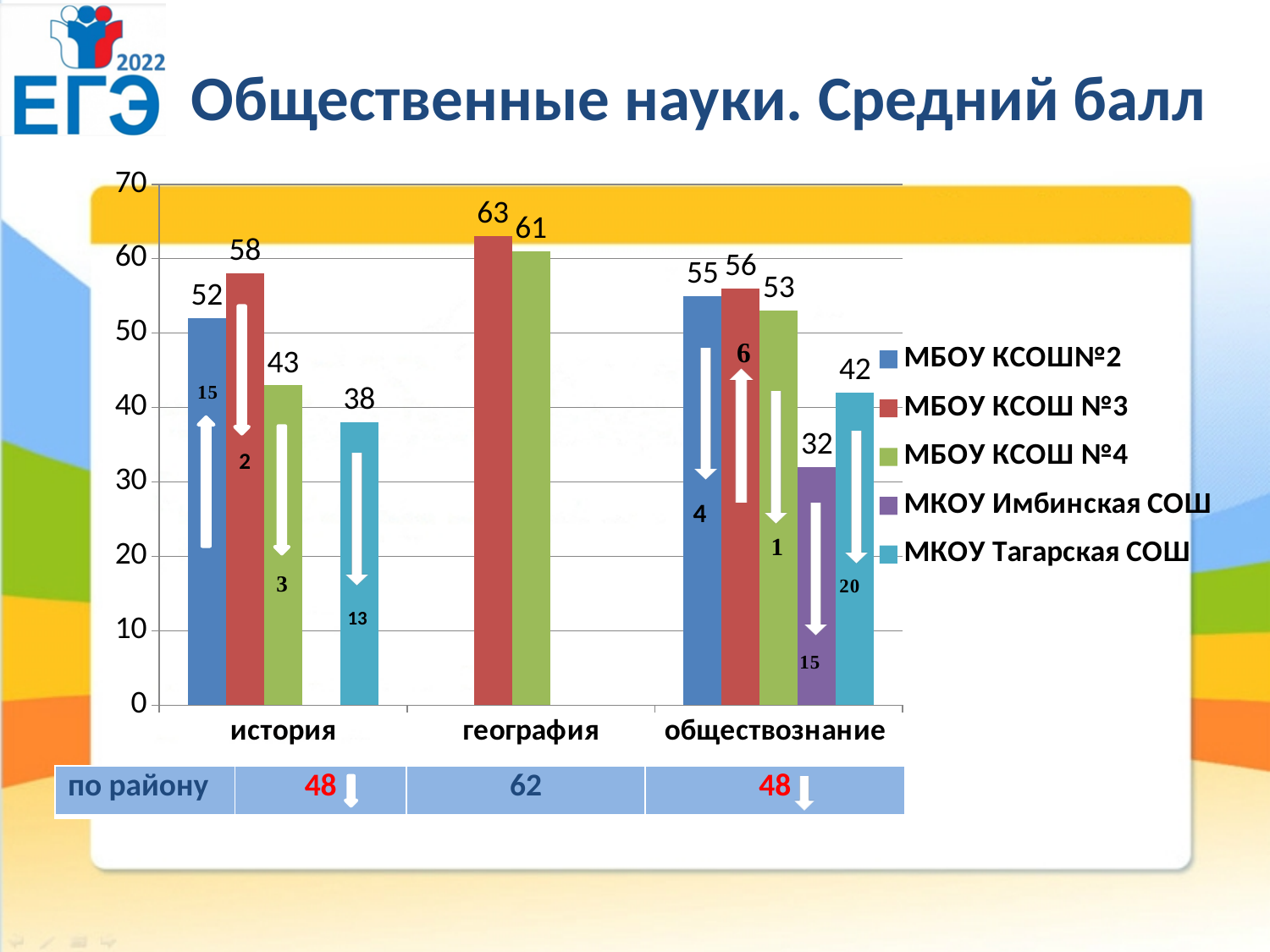
Which school has the lowest average score in обществознание? МКОУ Имбинская СОШ What is the average score for МБОУ КСОШ №4 in география? 61 Which is larger: the score of МБОУ КСОШ №4 in история or in обществознание? обществознание What is the district average (по району) for география shown below the chart? 62 What is the difference between the scores of МБОУ КСОШ№2 and МКОУ Тагарская СОШ in история? 14 What is the average score for МБОУ КСОШ №3 in история? 58 How many series does the legend list? 5 What is the average score for МКОУ Тагарская СОШ in обществознание? 42 What kind of chart is shown on the slide? bar chart Which school has the highest average score in история? МБОУ КСОШ №3 How many subject categories are shown on the x axis? 3 What is the difference between the scores of МБОУ КСОШ №3 and МБОУ КСОШ №4 in география? 2